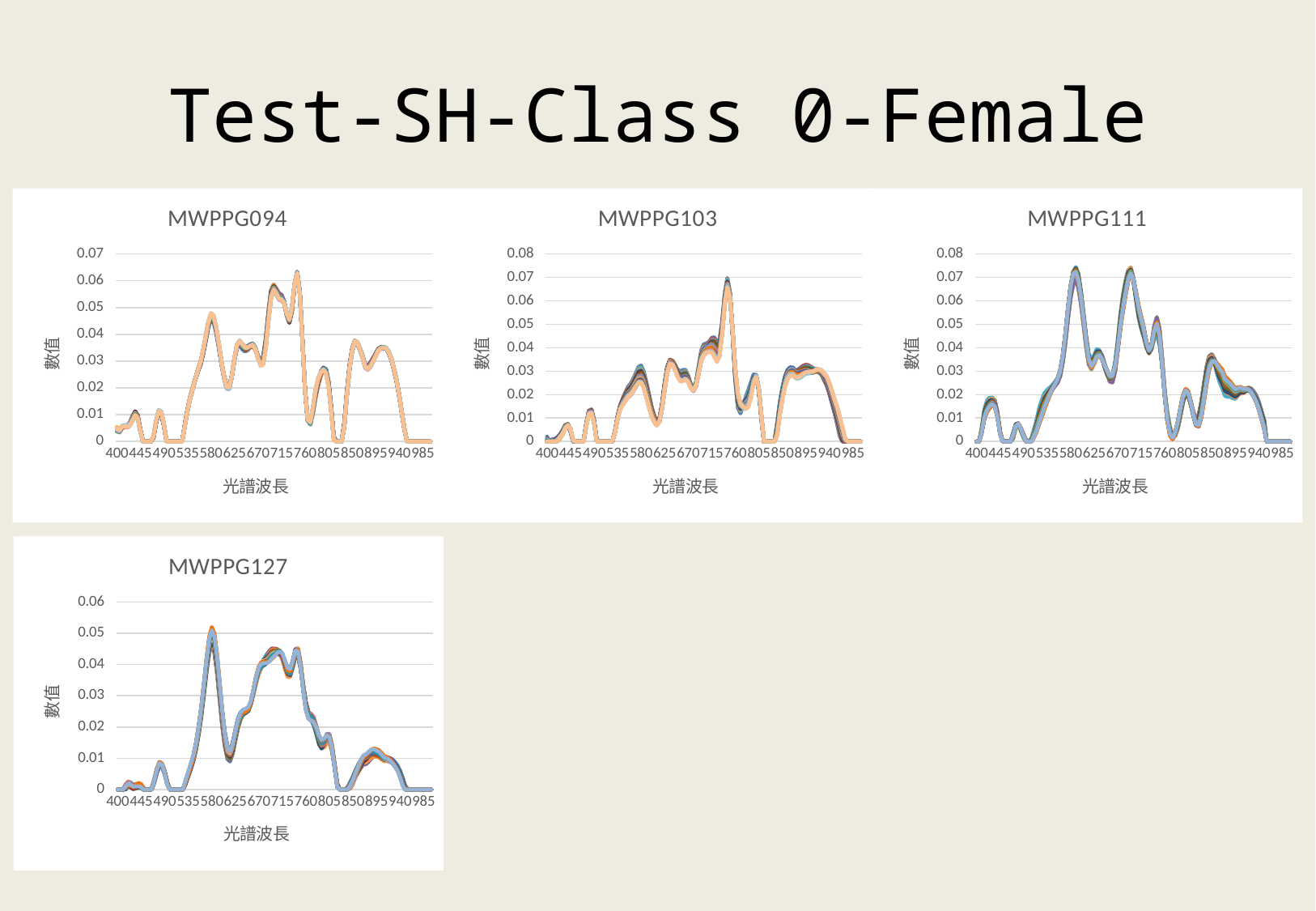
How many charts are shown on the slide? 4 In the MWPPG094 chart, is the highest peak of the lines greater or less than 0.05? greater What is the x-axis title of the MWPPG111 chart? 光譜波長 In the MWPPG111 chart, is the value at 580 greater or less than 0.06? greater In the MWPPG103 chart, is the value at 400 greater or less than 0.01? less What is the highest y-axis tick label on the MWPPG127 chart? 0.06 What kind of chart is MWPPG094? line chart